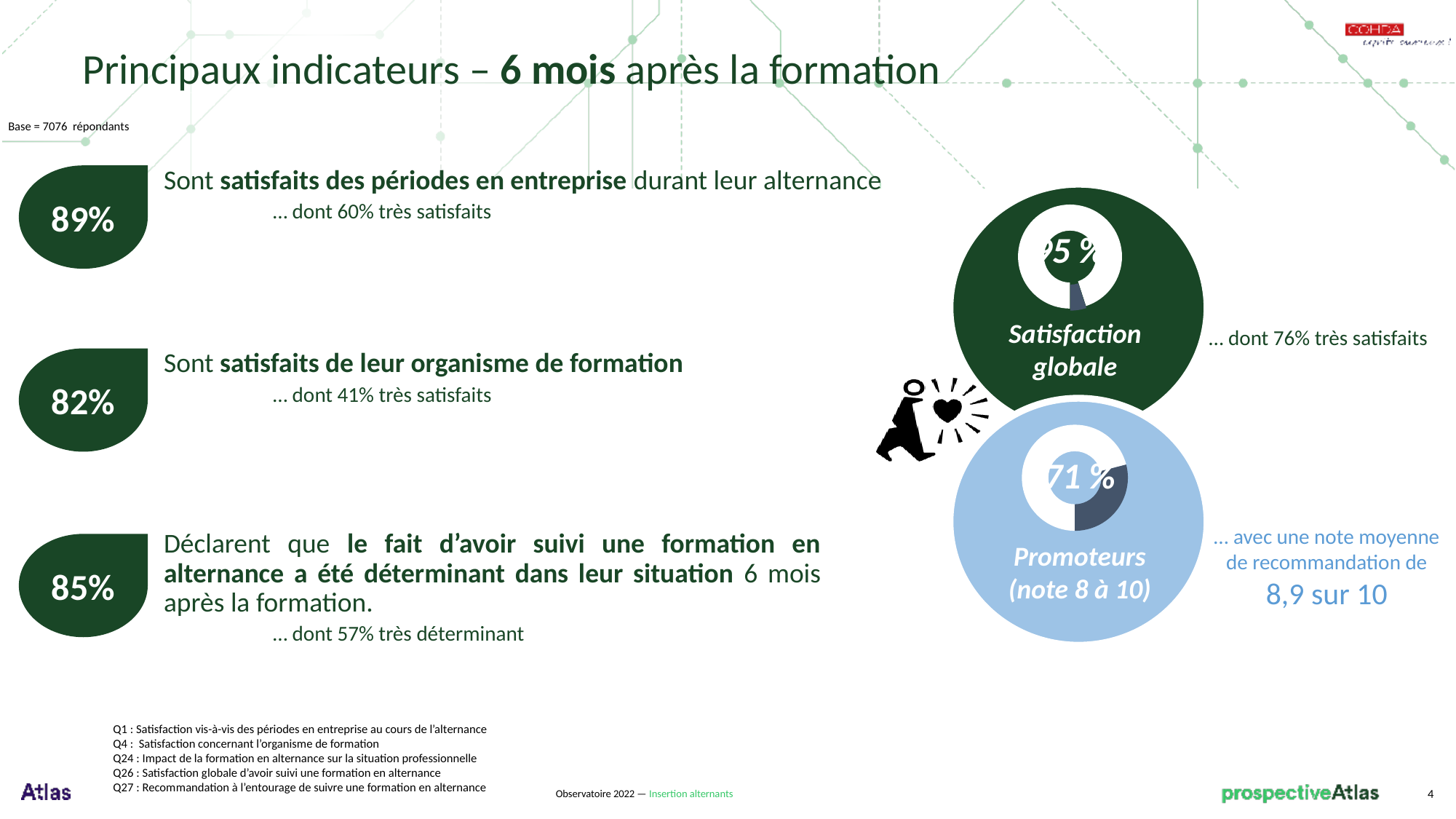
What is the difference in percentage points between the 'Satisfaction globale' value and the 'Promoteurs (note 8 à 10)' value? 24 In the 'Promoteurs (note 8 à 10)' chart, what percentage is shown? 71 % What is the label written under the lower donut chart on the right of the slide? Promoteurs (note 8 à 10) In the 'Satisfaction globale' chart, what percentage is shown? 95 % How many donut charts are shown on the slide? 2 What is the background colour of the circle containing the 'Promoteurs (note 8 à 10)' chart? light blue Which chart shows the larger value, 'Satisfaction globale' or 'Promoteurs (note 8 à 10)'? Satisfaction globale What kind of chart is the 'Satisfaction globale' chart? pie chart (donut)